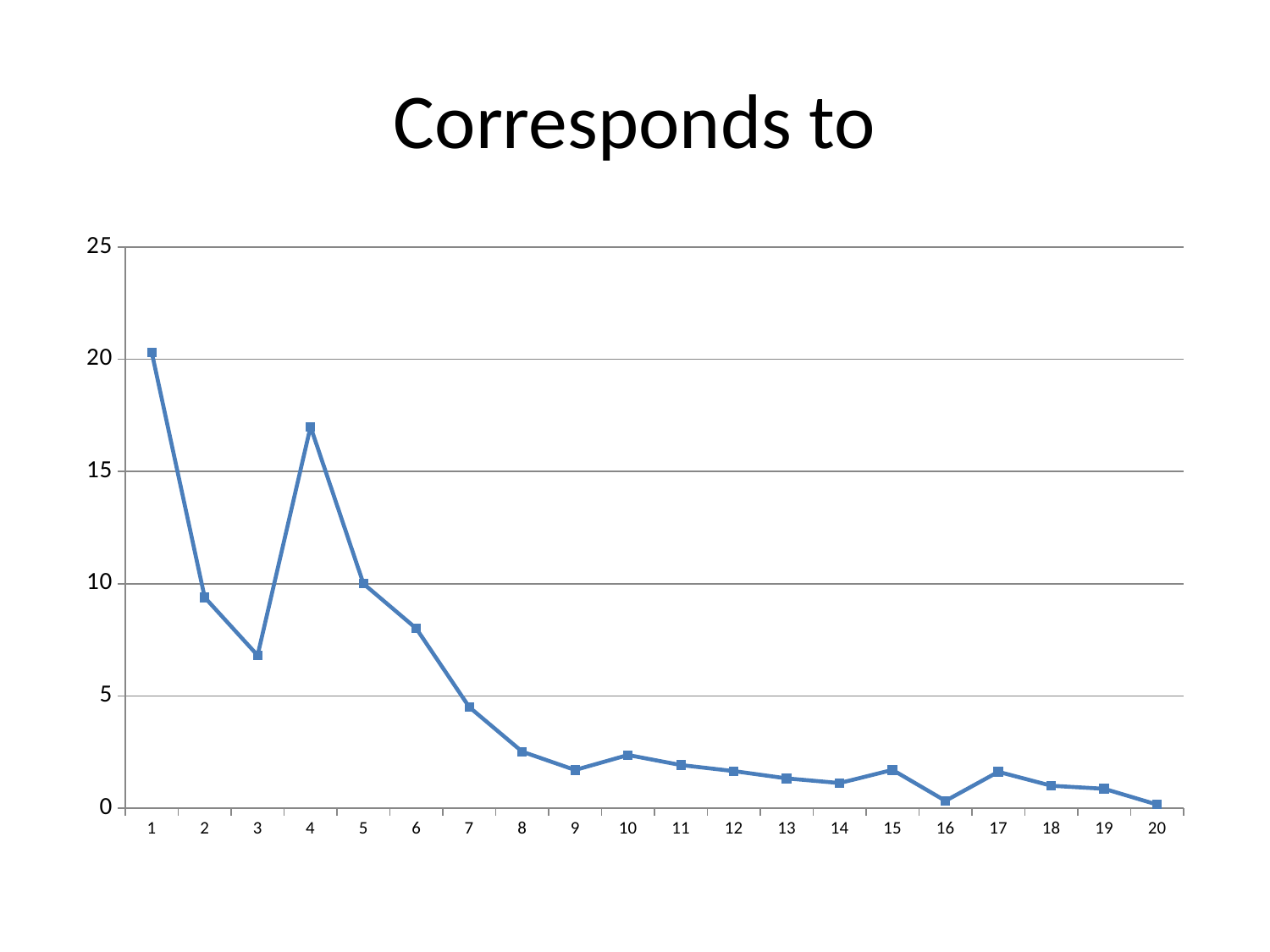
Is the value at x = 16 greater or less than 5? less Which has the larger value, x = 4 or x = 2? 4 Which x-axis category has the highest value? 1 What is the title of the slide? Corresponds to How many points are plotted along the x axis? 20 Is the value at x = 4 greater or less than 15? greater Is the value at x = 3 greater or less than 5? greater What kind of chart is shown on the slide? line chart Do the values generally rise or fall from x = 5 to x = 20? fall